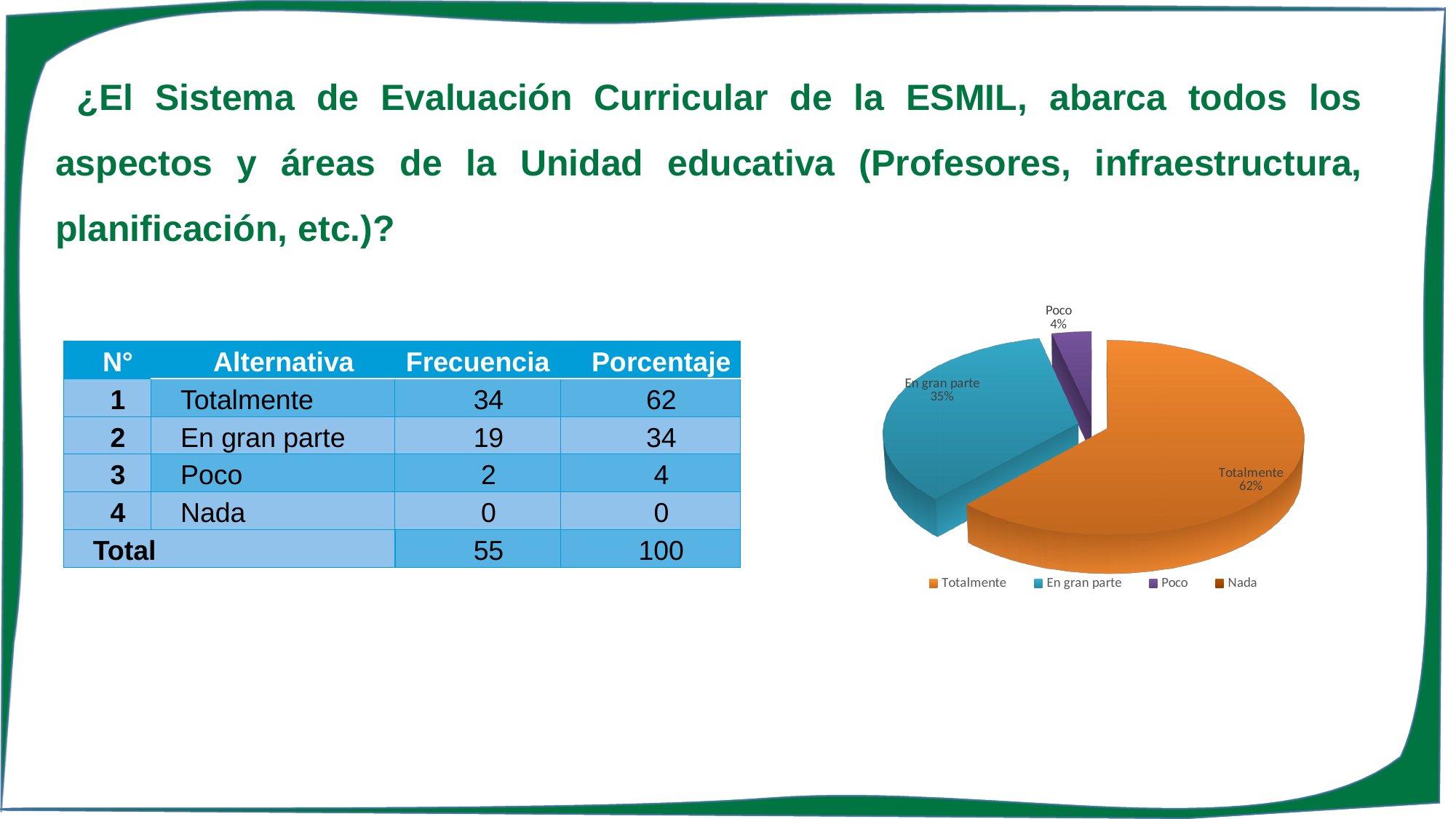
Which category has the largest slice in the pie chart? Totalmente Which legend entry of the pie chart has no visible slice? Nada What colour is the Totalmente slice in the pie chart? orange What percentage does the pie chart show for Poco? 4% What percentage does the pie chart show for En gran parte? 35% How many entries does the pie chart legend list? 4 Which labelled slice in the pie chart is the smallest? Poco What type of chart is shown on the slide? pie chart In the pie chart, which is larger: the slice for Totalmente or the slice for En gran parte? Totalmente What is the difference in percentage points between the Totalmente slice and the En gran parte slice in the pie chart? 27 What is the difference in percentage points between the En gran parte slice and the Poco slice in the pie chart? 31 What percentage does the pie chart show for Totalmente? 62%